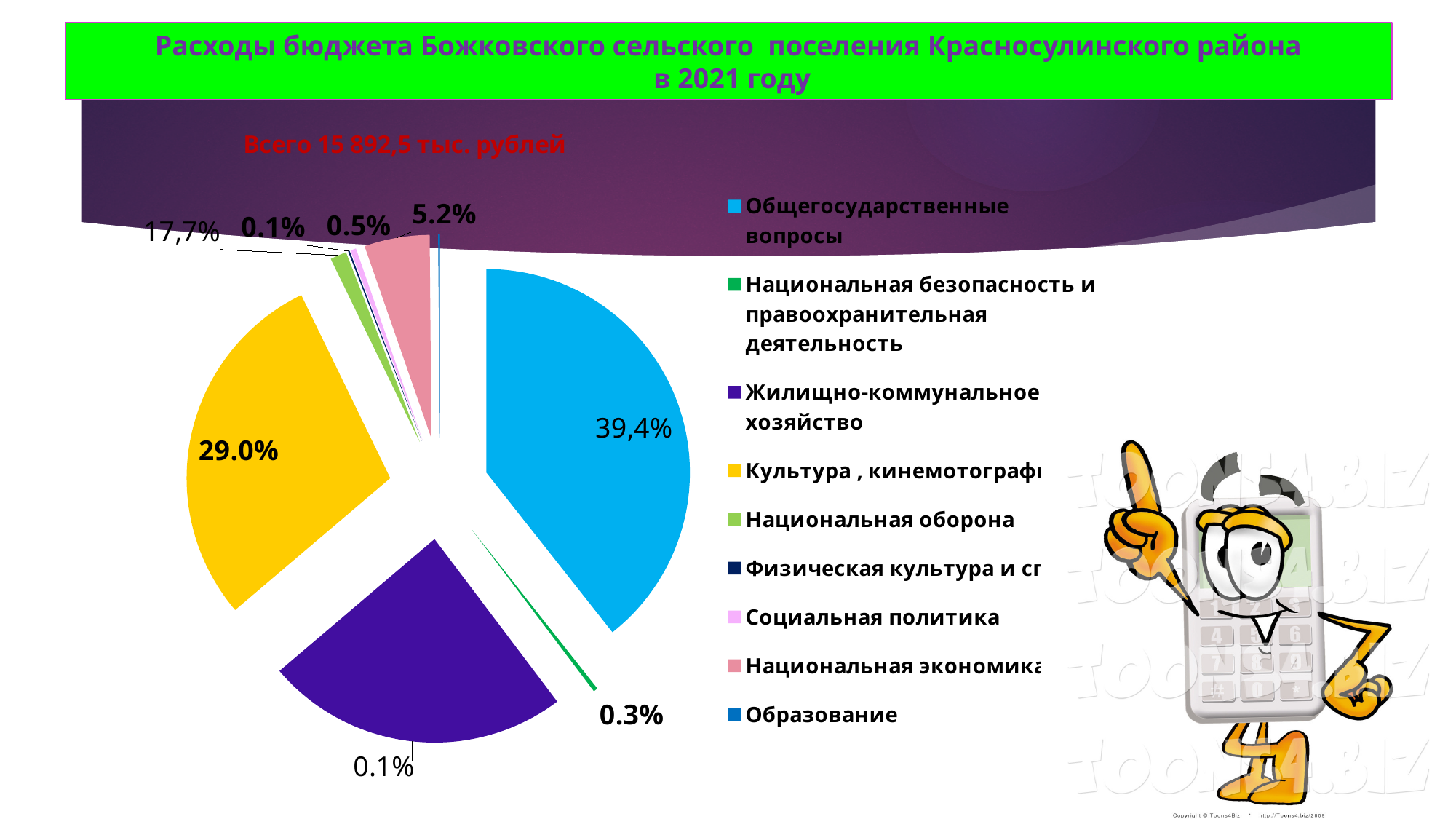
What is the title of the chart on the slide? Всего 15 892,5 тыс. рублей What share of the budget expenditure goes to Общегосударственные вопросы? 39,4% What total amount of expenditure is stated above the pie chart? Всего 15 892,5 тыс. рублей Which category has the largest share of the budget expenditure? Общегосударственные вопросы Which share is larger: Общегосударственные вопросы or Культура, кинемотография? Общегосударственные вопросы What share of the budget expenditure goes to Культура, кинемотография? 29.0% By how many percentage points does the share of Общегосударственные вопросы exceed the share of Культура, кинемотография? 10,4% What share of the budget expenditure goes to Национальная экономика? 5.2% How many categories does the legend of the pie chart list? 9 Which share is larger: Национальная экономика or Национальная безопасность и правоохранительная деятельность? Национальная экономика What share of the budget expenditure goes to Национальная безопасность и правоохранительная деятельность? 0.3% What kind of chart is shown on the slide? pie chart